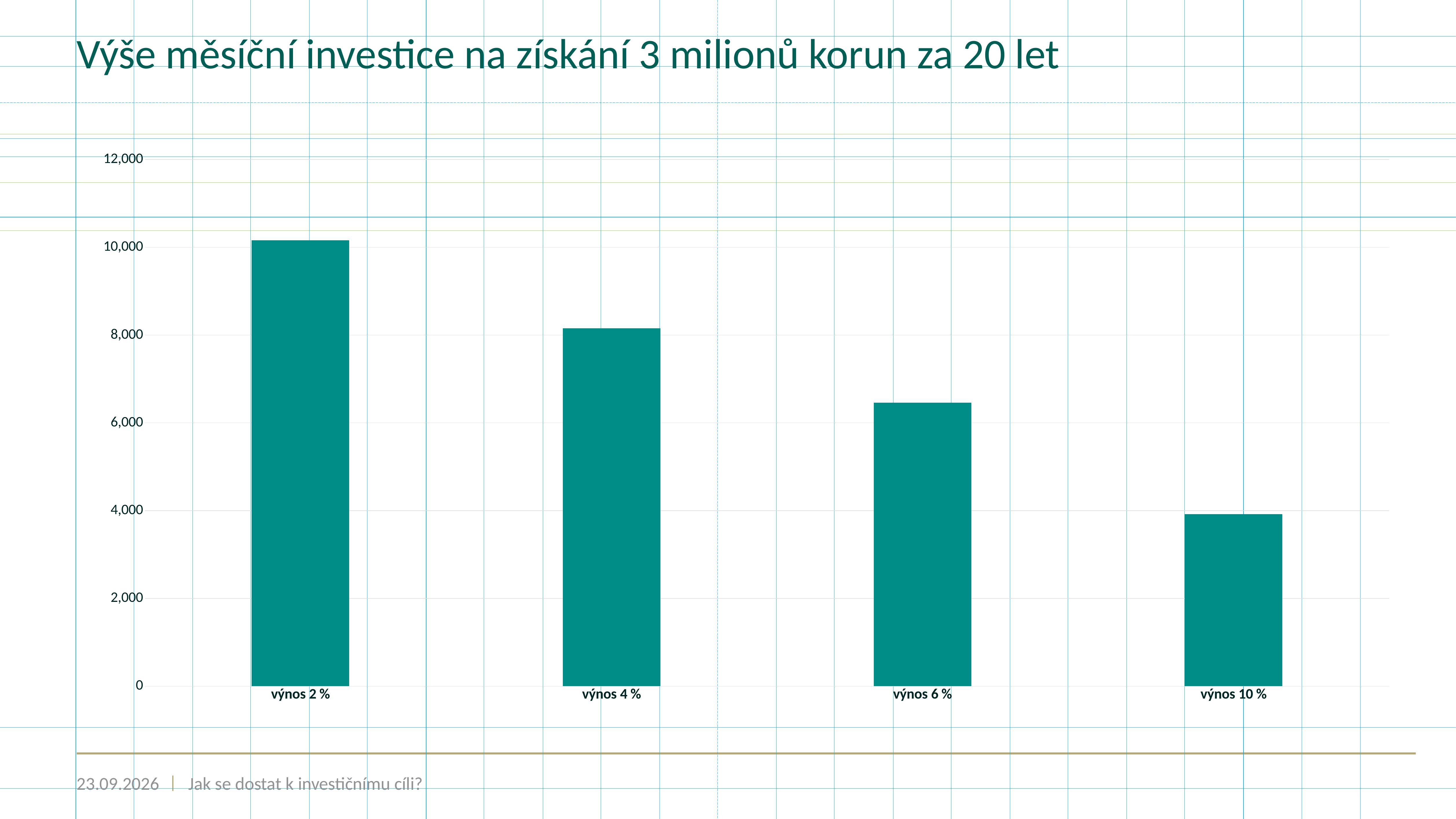
What kind of chart is shown on the slide? bar chart Is the value for výnos 6 % greater or less than 6,000? greater Is the value for výnos 4 % greater or less than 10,000? less What is the title of the chart? Výše měsíční investice na získání 3 milionů korun za 20 let Which is larger, the value for výnos 4 % or the value for výnos 6 %? výnos 4 % Which category has the lowest bar? výnos 10 % Do the bar values rise or fall from left to right along the x axis? fall How many categories are shown on the x axis of the chart? 4 Is the value for výnos 10 % greater or less than 6,000? less Which is larger, the value for výnos 10 % or the value for výnos 2 %? výnos 2 % Which category has the highest bar? výnos 2 %